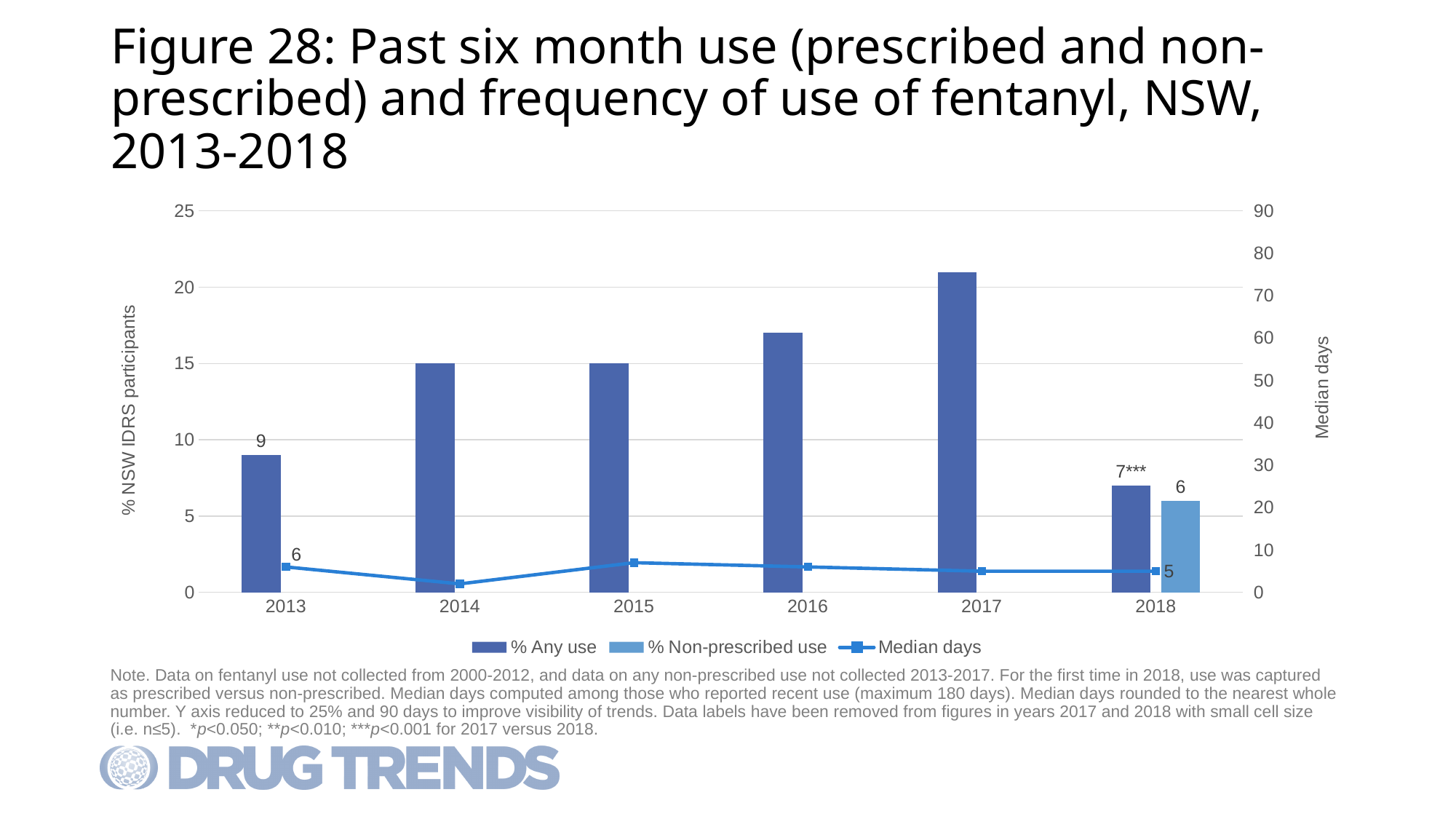
How many series does the legend list? 3 What is the difference between % Any use in 2013 and in 2018? 2 What is the Median days value in 2018? 5 What is the value of % Any use in 2018? 7 Which is larger, the % Any use in 2013 or in 2018? 2013 Which year has the lowest % Any use? 2018 What is the value of % Non-prescribed use in 2018? 6 Which year has the highest % Any use? 2017 How many years are shown on the x axis? 6 Is the % Any use value for 2017 greater or less than 20? greater What is the value of % Any use in 2013? 9 What is the Median days value in 2013? 6